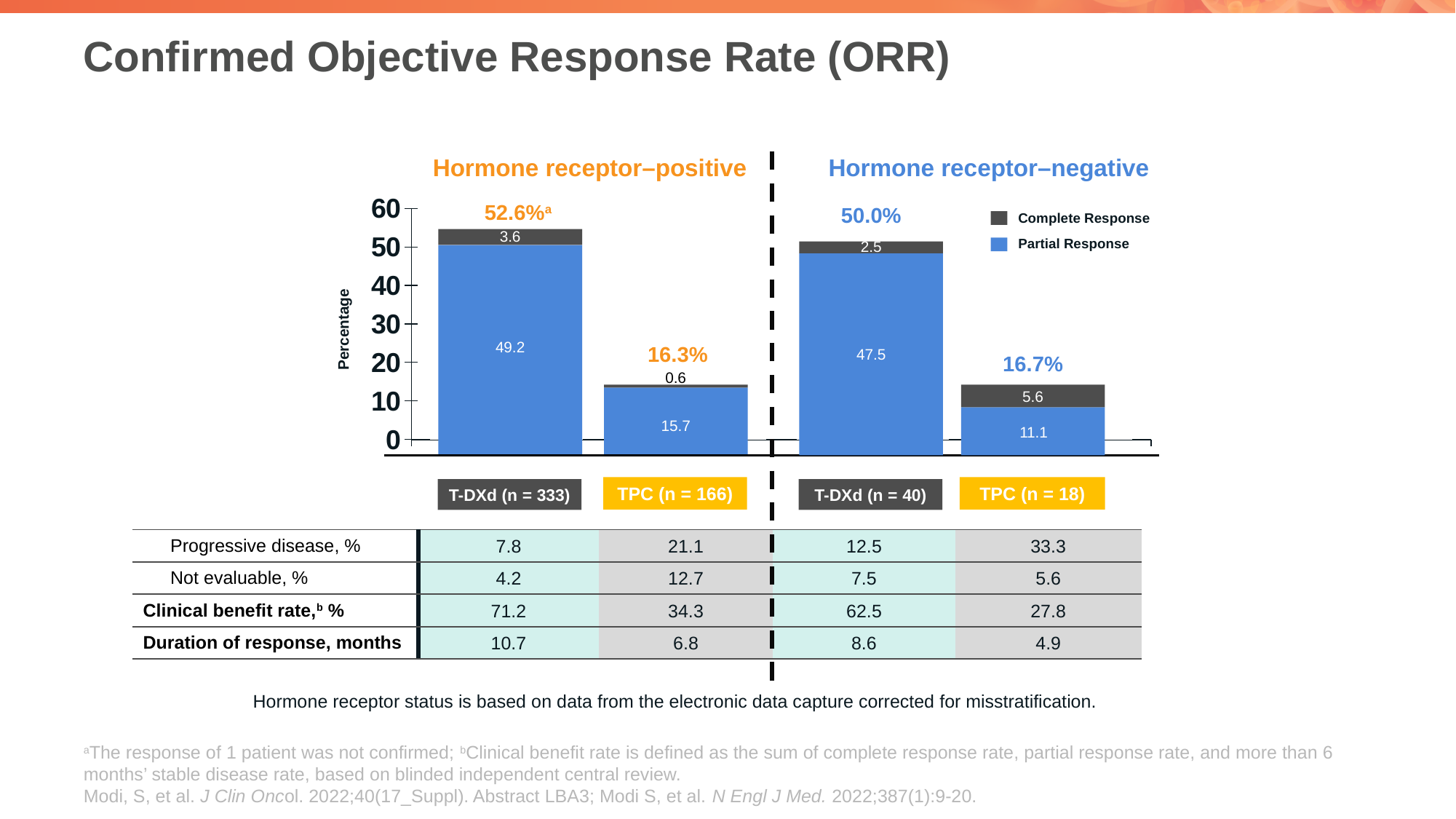
Which has a larger complete response percentage: T-DXd in the hormone receptor–positive group or TPC in the hormone receptor–negative group? TPC in the hormone receptor–negative group Which bar has the highest total ORR across both panels? T-DXd (n = 333) What is the complete response percentage for TPC (n = 18) in the hormone receptor–negative group? 5.6 What is the complete response percentage for TPC (n = 166) in the hormone receptor–positive group? 0.6 Which bar has the lowest total ORR across both panels? TPC (n = 166) What is the partial response percentage for T-DXd (n = 333) in the hormone receptor–positive group? 49.2 Is the total ORR for TPC (n = 18) in the hormone receptor–negative group greater or less than 20? less What type of chart is used to show the confirmed objective response rates? Stacked bar chart How many series does the chart legend list? 2 What is the total ORR for the TPC (n = 166) bar in the hormone receptor–positive group? 16.3% What is the confirmed ORR shown above the T-DXd bar in the hormone receptor–negative group? 50.0% What is the difference in partial response percentage between T-DXd and TPC in the hormone receptor–positive group? 33.5